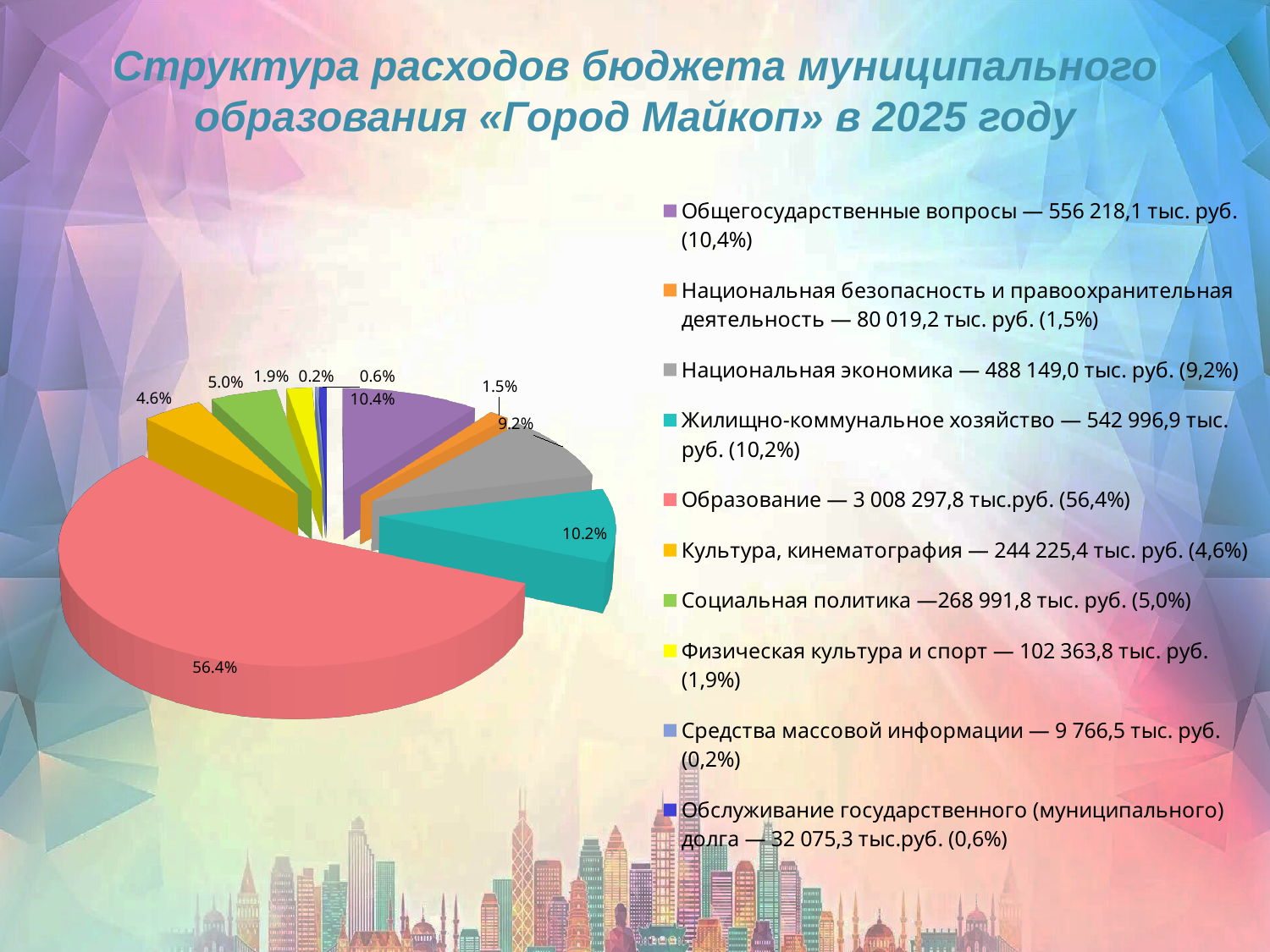
Which has the larger share: Общегосударственные вопросы or Жилищно-коммунальное хозяйство? Общегосударственные вопросы What share of the pie does Образование have? 56.4% What is the title of the slide? Структура расходов бюджета муниципального образования «Город Майкоп» в 2025 году What type of chart is shown on the slide? pie chart According to the legend, what is the amount for Социальная политика? 268 991,8 тыс. руб. What share of the pie does Физическая культура и спорт have? 1.9% How many categories does the legend list? 10 Which category has the largest share of the pie? Образование What is the difference in percentage points between the shares of Образование and Общегосударственные вопросы? 46.0 What share of the pie does Национальная экономика have? 9.2% Which category has the smallest share of the pie? Средства массовой информации According to the legend, what is the amount for Культура, кинематография? 244 225,4 тыс. руб.